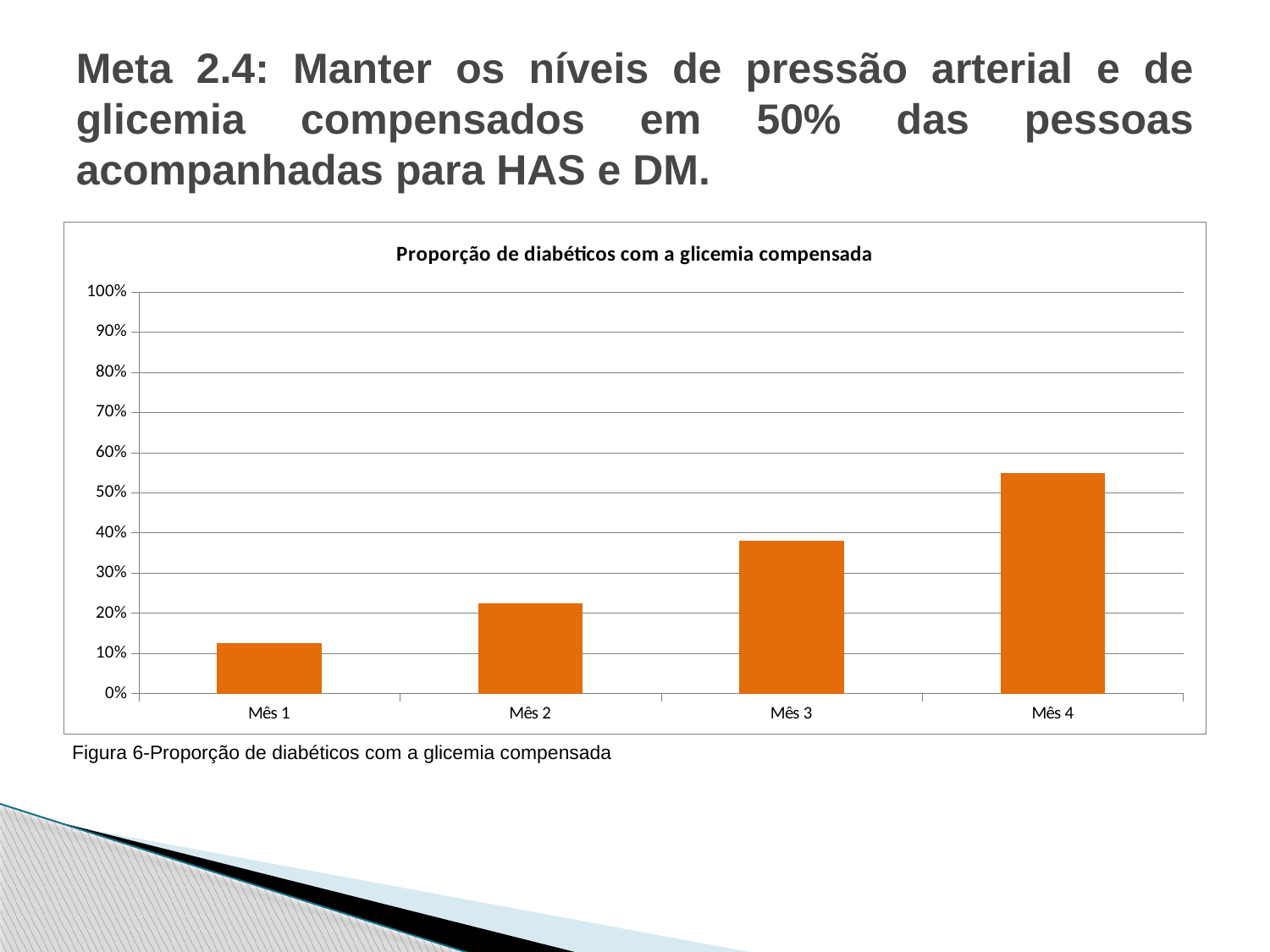
Is the value for Mês 4 greater or less than 60%? less Is the value for Mês 3 greater or less than 30%? greater Is the value for Mês 1 greater or less than 20%? less Which month has the lowest proportion of diabetics with compensated glycemia? Mês 1 What is the title of the chart? Proporção de diabéticos com a glicemia compensada Which month has the highest proportion of diabetics with compensated glycemia? Mês 4 Which is larger, the value for Mês 2 or the value for Mês 3? Mês 3 What type of chart is shown on the slide? bar chart How many months (categories) are shown on the x axis of the chart? 4 Do the values rise or fall from Mês 1 to Mês 4? rise